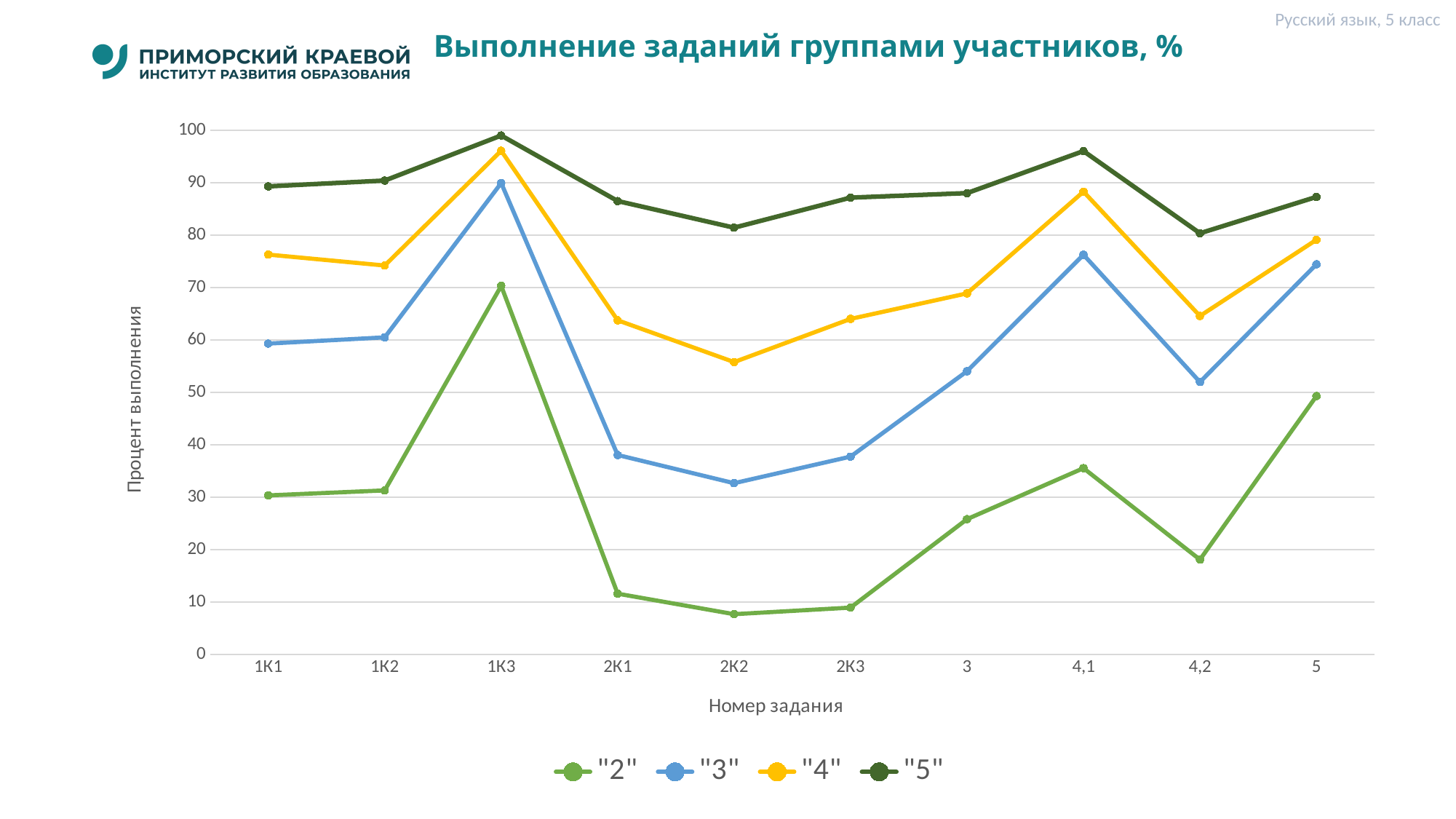
How many task numbers (categories) are shown on the x axis? 10 For which task does the "2" group reach its highest completion percentage? 1К3 For which task does the "4" group have its lowest completion percentage? 2К2 For which task does the "5" group reach its highest completion percentage? 1К3 What kind of chart is shown on the slide? line chart For which task does the "2" group have its lowest completion percentage? 2К2 Is the value for the "3" group at task 1К3 greater or less than 80? greater What is the title of the x axis? Номер задания Is the value for the "2" group at task 2К2 greater or less than 10? less At task 2К1, which group has the higher completion percentage, "4" or "3"? "4" For which task does the "5" group have its lowest completion percentage? 4,2 How many series does the legend list? 4